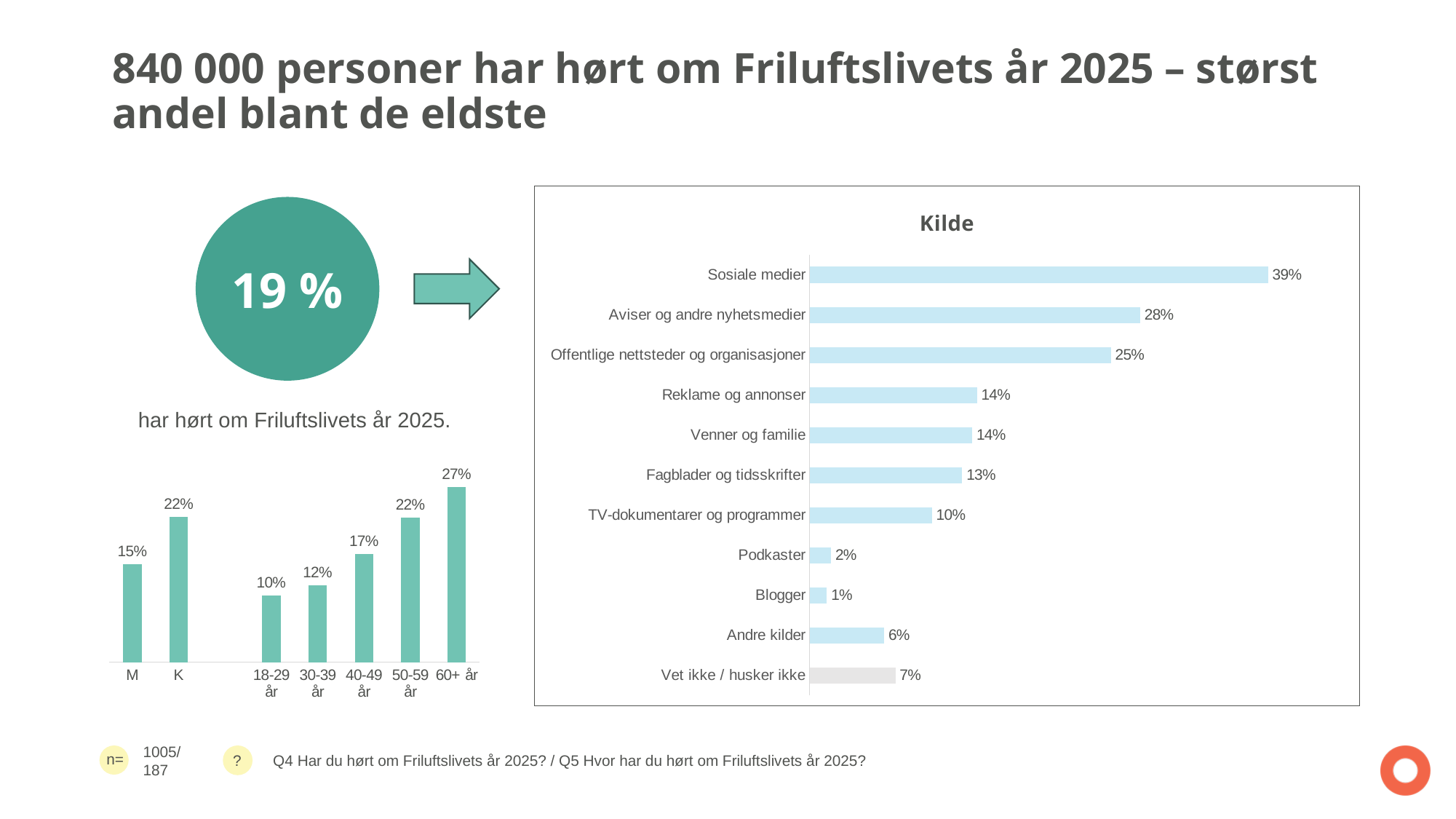
In the 'Kilde' chart, which is larger: Podkaster or Andre kilder? Andre kilder In the bar chart on the left of the slide, which age group has the lowest value? 18-29 år In the bar chart on the left of the slide, what is the value for 60+ år? 27% In the bar chart on the left of the slide, what is the difference between K and M? 7% What kind of chart is the 'Kilde' chart? Bar chart In the 'Kilde' chart, which source has the lowest value? Blogger In the 'Kilde' chart, how many sources are listed? 11 In the 'Kilde' chart, what is the value for Sosiale medier? 39% In the bar chart on the left of the slide, do the values rise or fall across the age groups from 18-29 år to 60+ år? Rise In the 'Kilde' chart, what is the value for TV-dokumentarer og programmer? 10% In the 'Kilde' chart, what is the difference between Aviser og andre nyhetsmedier and Offentlige nettsteder og organisasjoner? 3% In the 'Kilde' chart, which source has the highest value? Sosiale medier